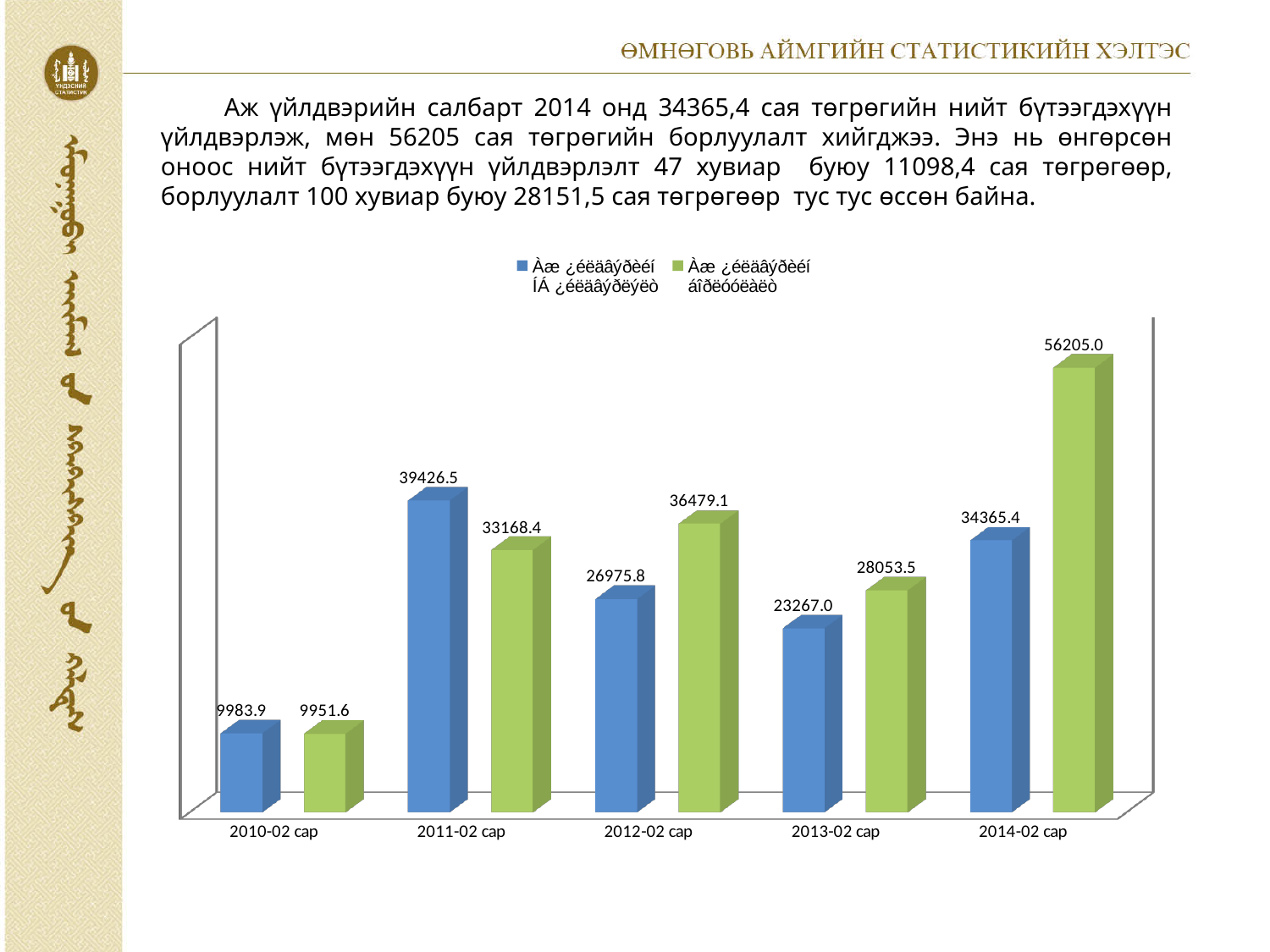
What is the value of the blue bar for 2011-02 сар? 39426.5 What is the value of the green bar for 2013-02 сар? 28053.5 Which category has the highest green bar? 2014-02 сар How many categories are shown on the x axis? 5 What kind of chart is shown on the slide? bar chart Which category has the highest blue bar? 2011-02 сар Which category has the lowest blue bar? 2010-02 сар What is the difference between the green and blue bars for 2014-02 сар? 21839.6 What is the value of the green bar for 2014-02 сар? 56205.0 For 2011-02 сар, which bar is larger, the blue or the green? blue How many series does the legend list? 2 What is the value of the blue bar for 2014-02 сар? 34365.4